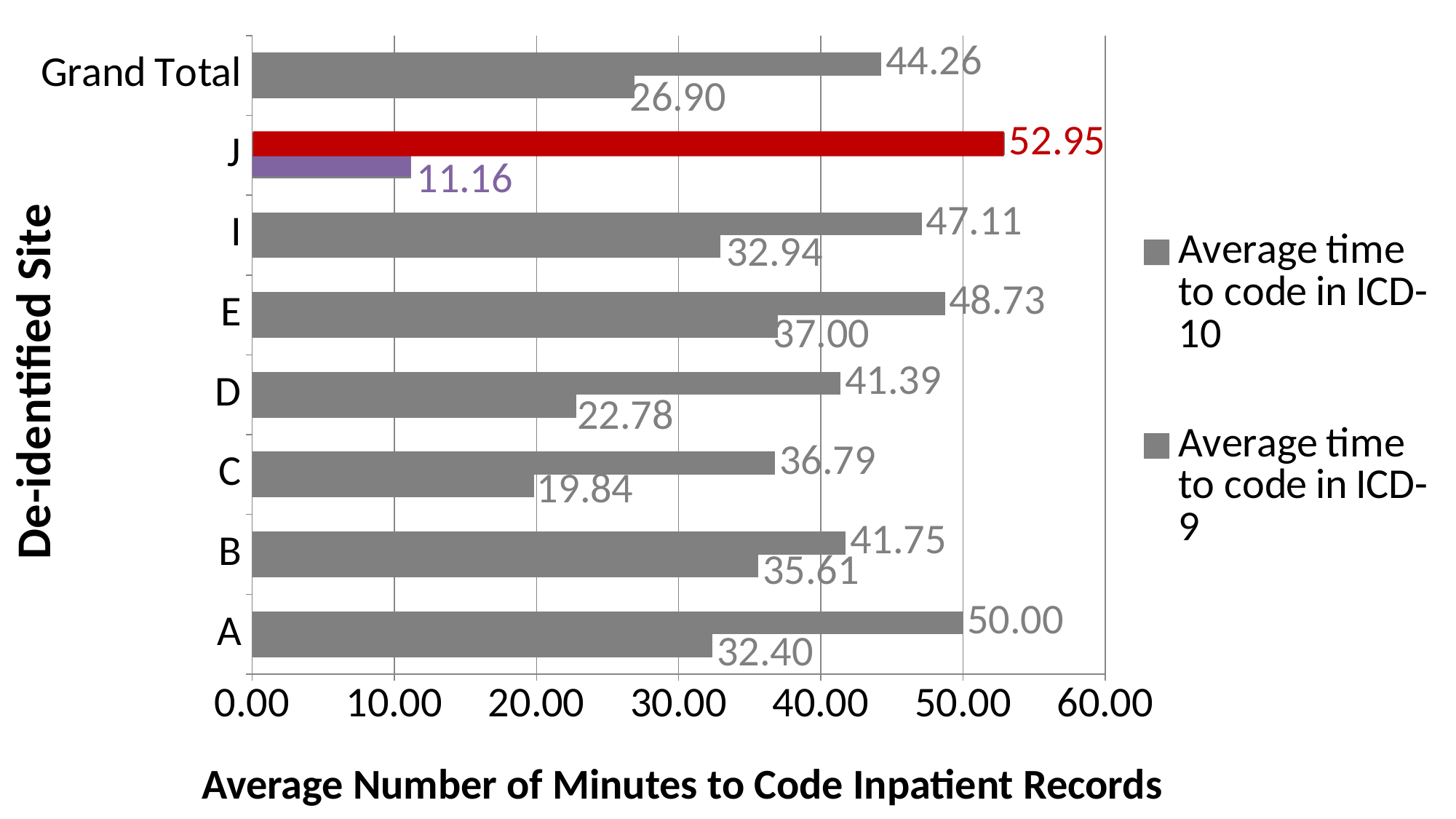
How many sites (including Grand Total) are shown on the y axis? 8 How many series does the legend list? 2 What is the average time to code in ICD-10 for site J? 52.95 What is the label of the x axis? Average Number of Minutes to Code Inpatient Records Which site has the lowest average time to code in ICD-9? J What is the average time to code in ICD-10 for the Grand Total? 44.26 What kind of chart is shown on the slide? Bar chart What is the average time to code in ICD-9 for site J? 11.16 What is the difference between the ICD-10 and ICD-9 average coding times for site A? 17.60 What is the average time to code in ICD-9 for site C? 19.84 Which is larger: the ICD-10 average time for site E or for site I? Site E Which site has the highest average time to code in ICD-10? J